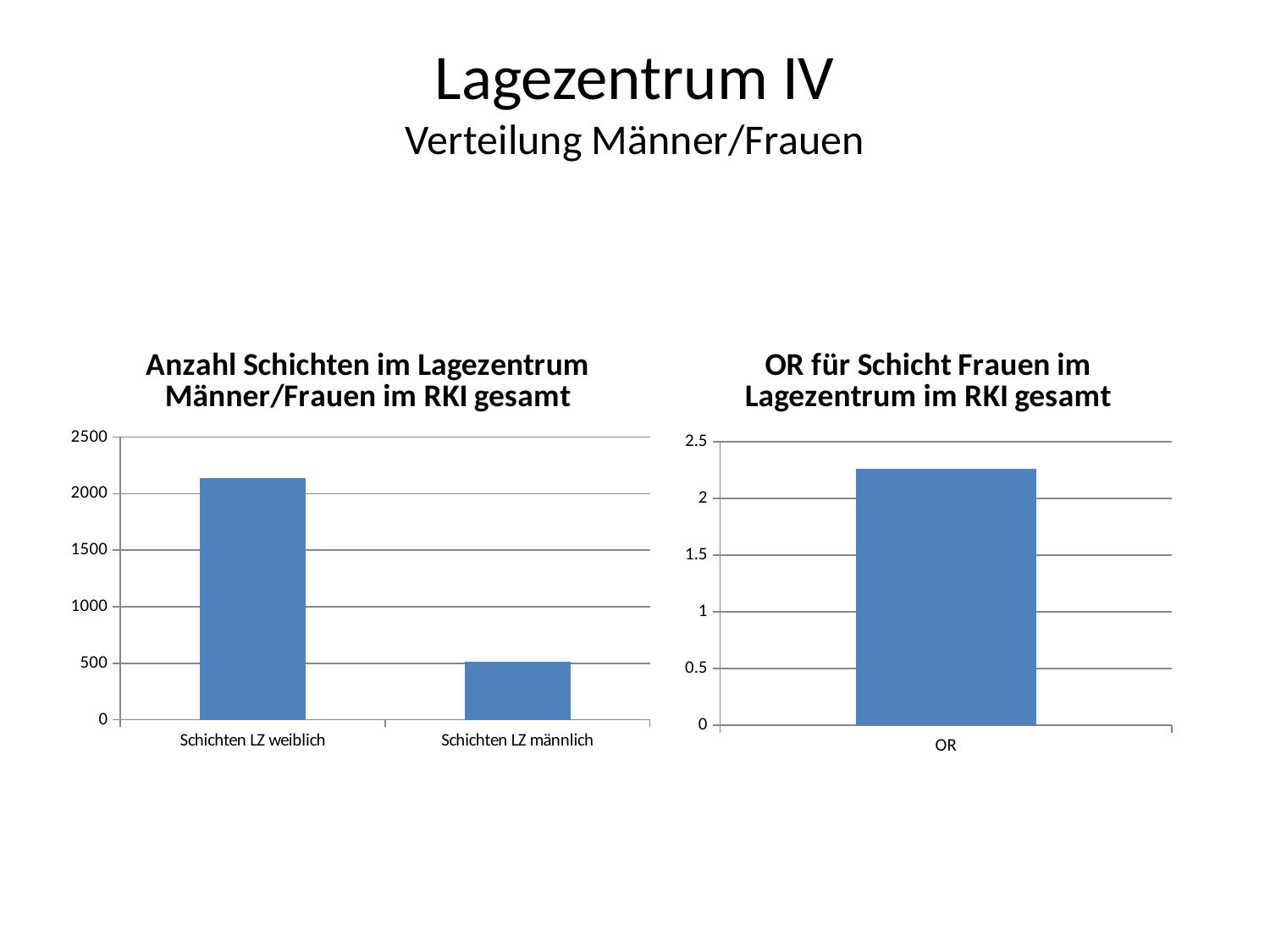
In the chart titled "OR für Schicht Frauen im Lagezentrum im RKI gesamt", is the value for OR greater or less than 2.5? less In the chart titled "Anzahl Schichten im Lagezentrum Männer/Frauen im RKI gesamt", what is the highest value shown on the vertical axis? 2500 In the chart titled "Anzahl Schichten im Lagezentrum Männer/Frauen im RKI gesamt", is the value for Schichten LZ männlich greater or less than 1000? less In the chart titled "Anzahl Schichten im Lagezentrum Männer/Frauen im RKI gesamt", is the value for Schichten LZ weiblich greater or less than 2000? greater In the chart titled "OR für Schicht Frauen im Lagezentrum im RKI gesamt", what is the label of the category on the x axis? OR In the chart titled "Anzahl Schichten im Lagezentrum Männer/Frauen im RKI gesamt", how many categories are plotted? 2 In the chart titled "Anzahl Schichten im Lagezentrum Männer/Frauen im RKI gesamt", which category has the lowest value? Schichten LZ männlich In the chart titled "Anzahl Schichten im Lagezentrum Männer/Frauen im RKI gesamt", which category has the highest value? Schichten LZ weiblich In the chart titled "Anzahl Schichten im Lagezentrum Männer/Frauen im RKI gesamt", which is larger: Schichten LZ weiblich or Schichten LZ männlich? Schichten LZ weiblich In the chart titled "Anzahl Schichten im Lagezentrum Männer/Frauen im RKI gesamt", what kind of chart is shown? bar chart In the chart titled "OR für Schicht Frauen im Lagezentrum im RKI gesamt", how many bars are plotted? 1